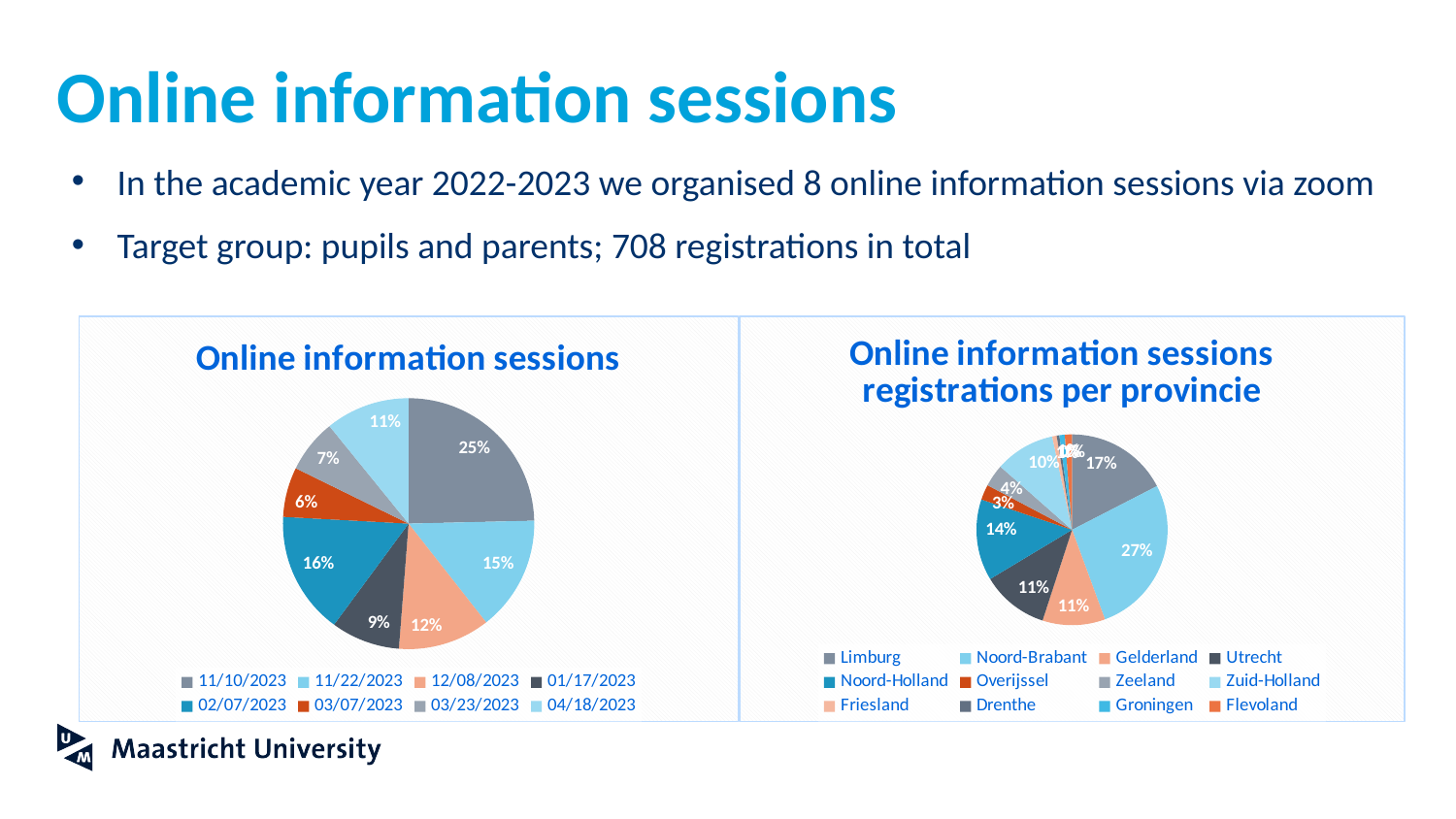
In the right chart titled "Online information sessions registrations per provincie", which is larger: the share for Limburg or the share for Noord-Holland? Limburg In the left chart titled "Online information sessions", which session has the smallest slice? 03/07/2023 In the right chart titled "Online information sessions registrations per provincie", how many provinces does the legend list? 12 In the left chart titled "Online information sessions", what is the difference in percentage points between the 11/22/2023 and 12/08/2023 slices? 3 In the right chart titled "Online information sessions registrations per provincie", what percentage of registrations came from Noord-Brabant? 27% In the left chart titled "Online information sessions", what share of the pie does the 11/10/2023 session have? 25% In the left chart titled "Online information sessions", which session has the largest slice? 11/10/2023 In the right chart titled "Online information sessions registrations per provincie", which province has the largest share of registrations? Noord-Brabant What kind of chart is the left chart titled "Online information sessions"? Pie chart In the right chart titled "Online information sessions registrations per provincie", what percentage is shown for Zuid-Holland? 10% In the left chart titled "Online information sessions", what percentage is shown for the 02/07/2023 session? 16% In the left chart titled "Online information sessions", how many sessions does the legend list? 8